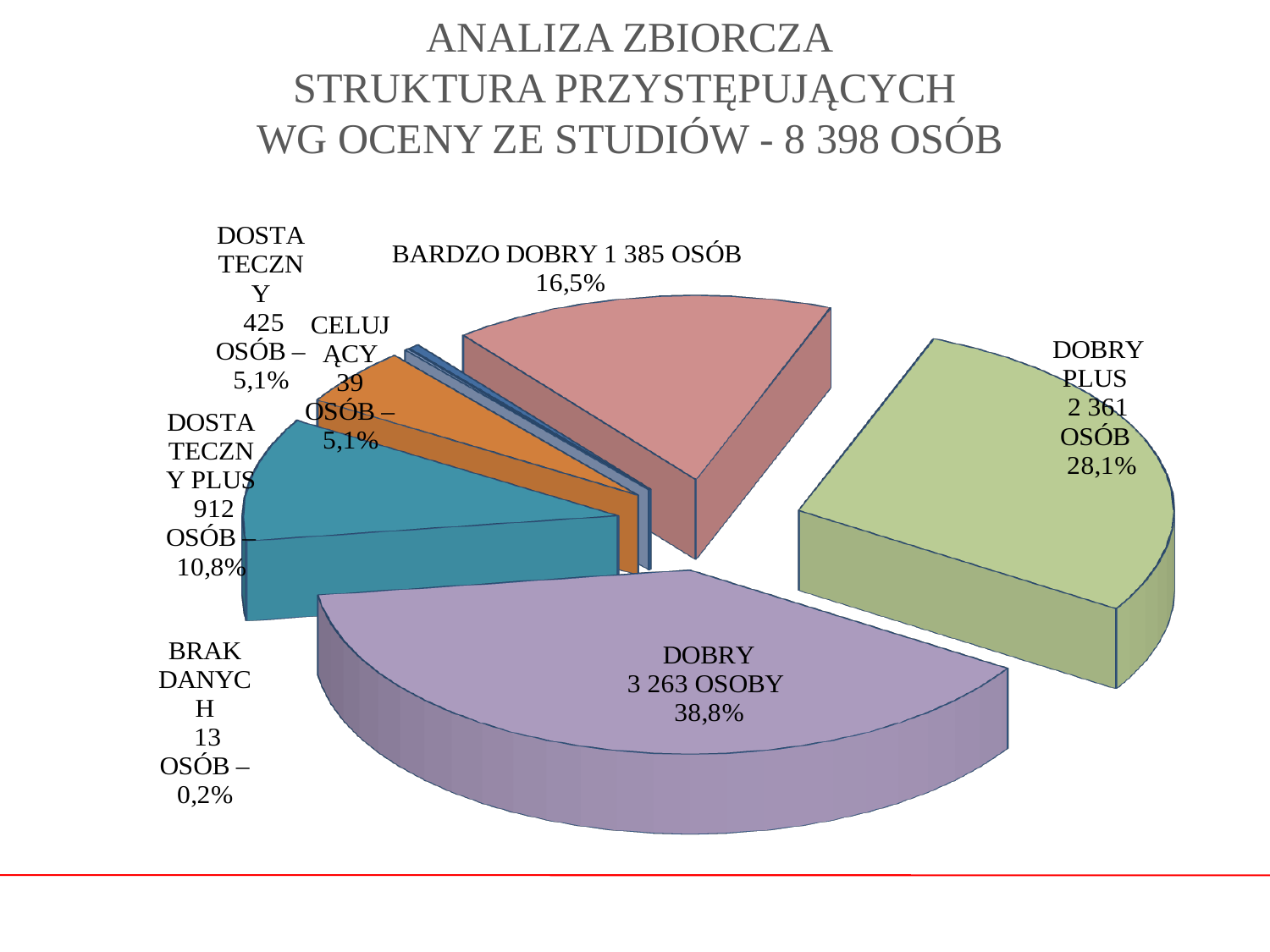
What kind of chart is shown on the slide? pie chart How many more people are in the DOBRY category than in the DOBRY PLUS category? 902 How many categories (slices) does the pie chart have? 7 Which category has more people: BARDZO DOBRY or DOSTATECZNY PLUS? BARDZO DOBRY Which category has the largest slice of the pie? DOBRY What is the difference in percentage points between the DOBRY PLUS and BARDZO DOBRY shares? 11,6% What percentage share does the BARDZO DOBRY slice have? 16,5% What percentage share does the DOBRY slice have? 38,8% How many people are in the DOSTATECZNY PLUS category? 912 How many people are in the DOBRY PLUS category? 2 361 Which category has the smallest slice of the pie? BRAK DANYCH According to the chart title, how many people in total are covered by the analysis? 8 398